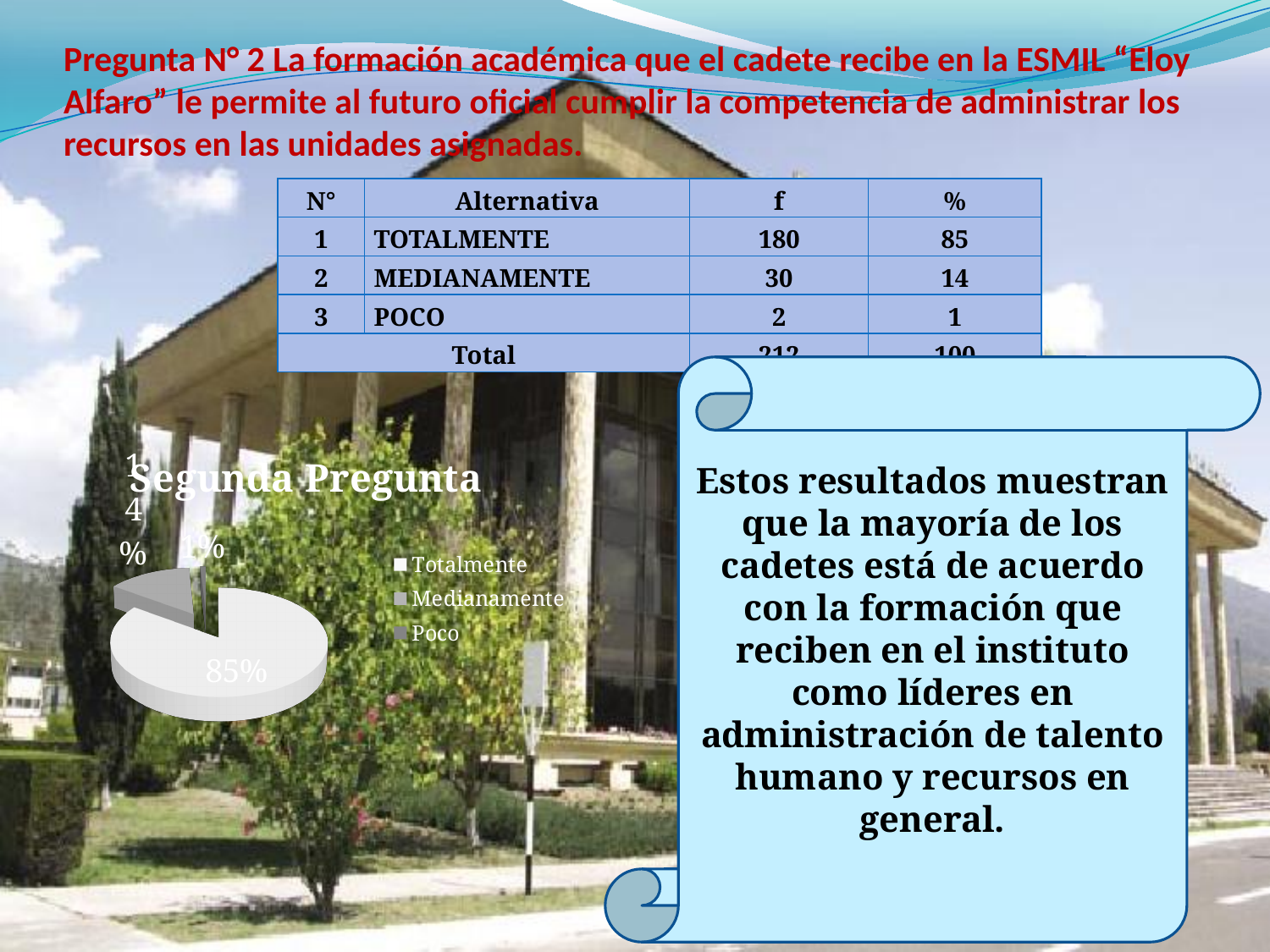
What is the difference in percentage points between the Totalmente and Poco slices? 84 Which legend entry is listed first in the pie chart's legend? Totalmente What share of the pie does the Poco slice represent? 1% How many entries does the pie chart's legend list? 3 Which category has the smallest slice in the pie chart? Poco Which slice is larger, Totalmente or Medianamente? Totalmente What share of the pie does the Totalmente slice represent? 85% What is the title of the pie chart? Segunda Pregunta Which category has the largest slice in the pie chart? Totalmente What share of the pie does the Medianamente slice represent? 14% What kind of chart is shown on the slide? pie chart How many slices does the pie chart have? 3